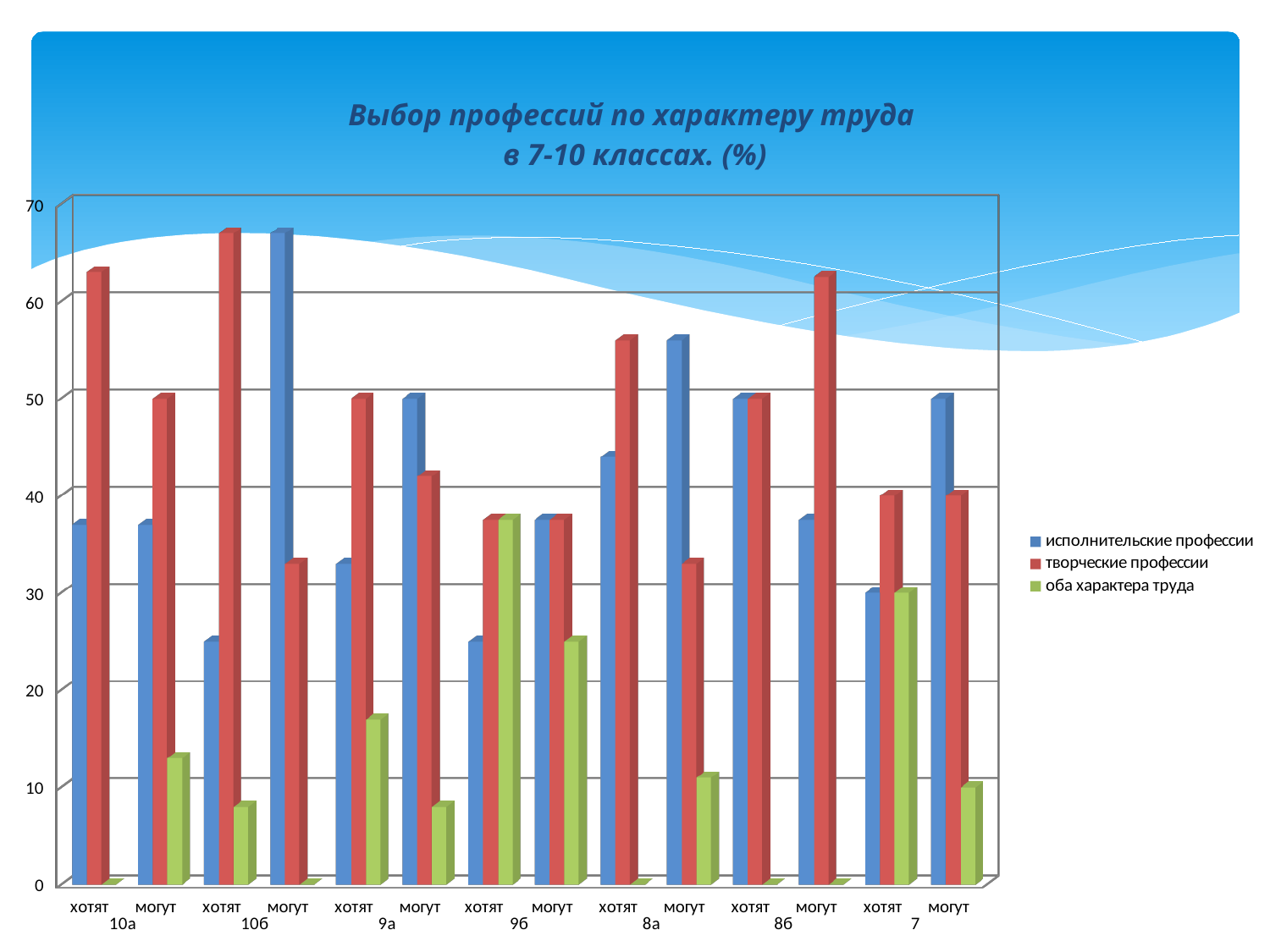
Which series is shown in green in the legend? оба характера труда How many class groups (10а, 10б, 9а, ...) are shown along the x axis? 7 Is the value for творческие профессии in 10а хотят greater or less than 60? greater For the series оба характера труда, which category has the highest value? 9б хотят What kind of chart is shown on the slide? bar chart In 8а могут, which is larger: исполнительские профессии or творческие профессии? исполнительские профессии Is the value for исполнительские профессии in 10б могут greater or less than 60? greater Is the value for оба характера труда in 8а могут greater or less than 20? less In 10а хотят, which is larger: исполнительские профессии or творческие профессии? творческие профессии How many series does the legend list? 3 What is the title of the chart? Выбор профессий по характеру труда в 7-10 классах. (%)